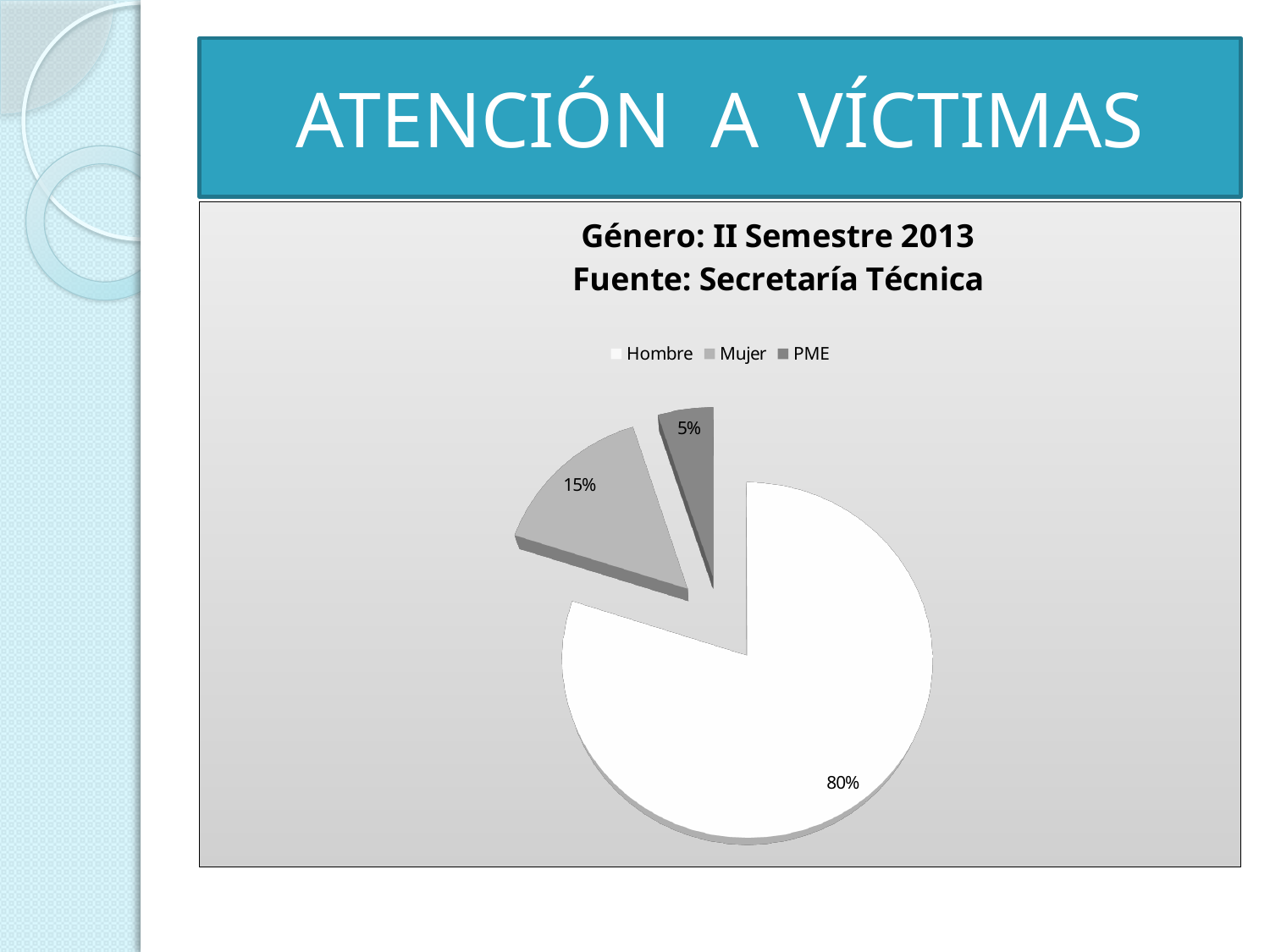
What share of the pie does Hombre represent? 80% What is the difference in percentage points between the Mujer and PME slices? 10 What share of the pie does Mujer represent? 15% Which categories are listed in the chart legend? Hombre, Mujer, PME Which slice is larger, Mujer or PME? Mujer What share of the pie does PME represent? 5% What is the difference in percentage points between the Hombre and Mujer slices? 65 What is the title of the chart? Género: II Semestre 2013 Fuente: Secretaría Técnica Which category has the smallest slice of the pie? PME What kind of chart is shown on the slide? Pie chart How many categories does the pie chart show? 3 Which category has the largest slice of the pie? Hombre